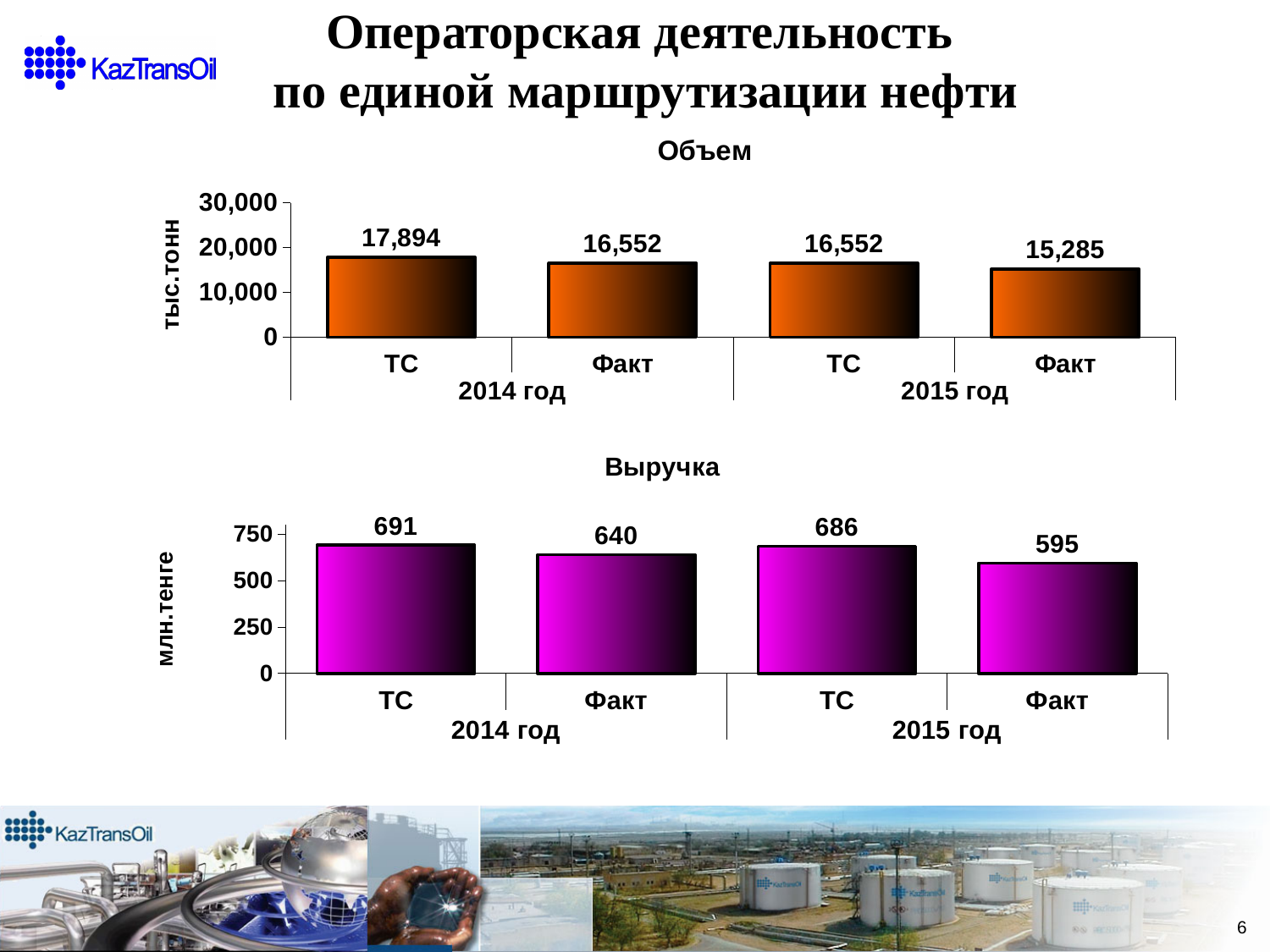
In the 'Объем' chart, what is the value for Факт in 2015 год? 15,285 In the 'Объем' chart, is the value for Факт in 2015 год greater or less than 20,000? less In the 'Выручка' chart, which bar has the lowest value? Факт 2015 год In the 'Выручка' chart, what is the value for ТС in 2015 год? 686 In the 'Объем' chart, which bar has the highest value? ТС 2014 год In the 'Объем' chart, what is the value for ТС in 2014 год? 17,894 In the 'Выручка' chart, which is larger: Факт in 2014 год or Факт in 2015 год? Факт in 2014 год What type of chart is the 'Выручка' chart? bar chart In the 'Объем' chart, how many bars are plotted? 4 What unit is shown on the y-axis of the 'Объем' chart? тыс.тонн In the 'Выручка' chart, what is the difference between ТС and Факт for 2015 год? 91 In the 'Объем' chart, what is the difference between ТС and Факт for 2014 год? 1,342